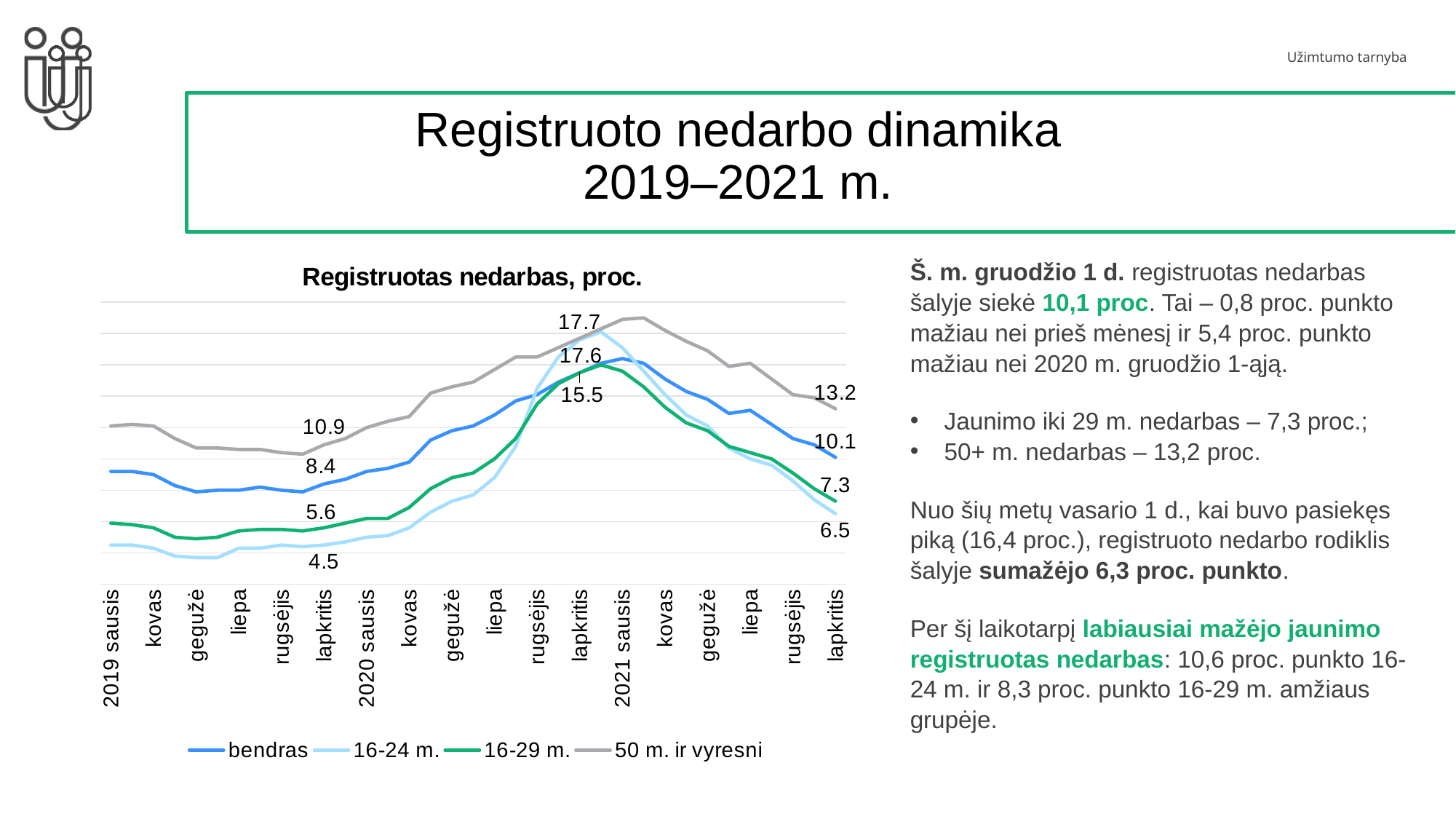
What is the value of the '50 m. ir vyresni' series at 2021 lapkritis? 13.2 At 2021 lapkritis, which series has the larger value: '16-29 m.' or '16-24 m.'? 16-29 m. At 2021 lapkritis, what is the difference between the '50 m. ir vyresni' value and the 'bendras' value? 3.1 What is the title of the chart? Registruotas nedarbas, proc. How many series does the legend of the chart list? 4 What is the value of the '16-29 m.' series at 2019 lapkritis? 5.6 What type of chart is shown on the slide? line chart What is the value of the 'bendras' series at 2019 lapkritis? 8.4 Which series has the highest value at 2021 lapkritis? 50 m. ir vyresni By how much did the 'bendras' value change between 2019 lapkritis (8.4) and 2021 lapkritis (10.1)? 1.7 What is the value of the 'bendras' series at 2021 lapkritis? 10.1 What is the value of the '16-24 m.' series at 2021 lapkritis? 6.5